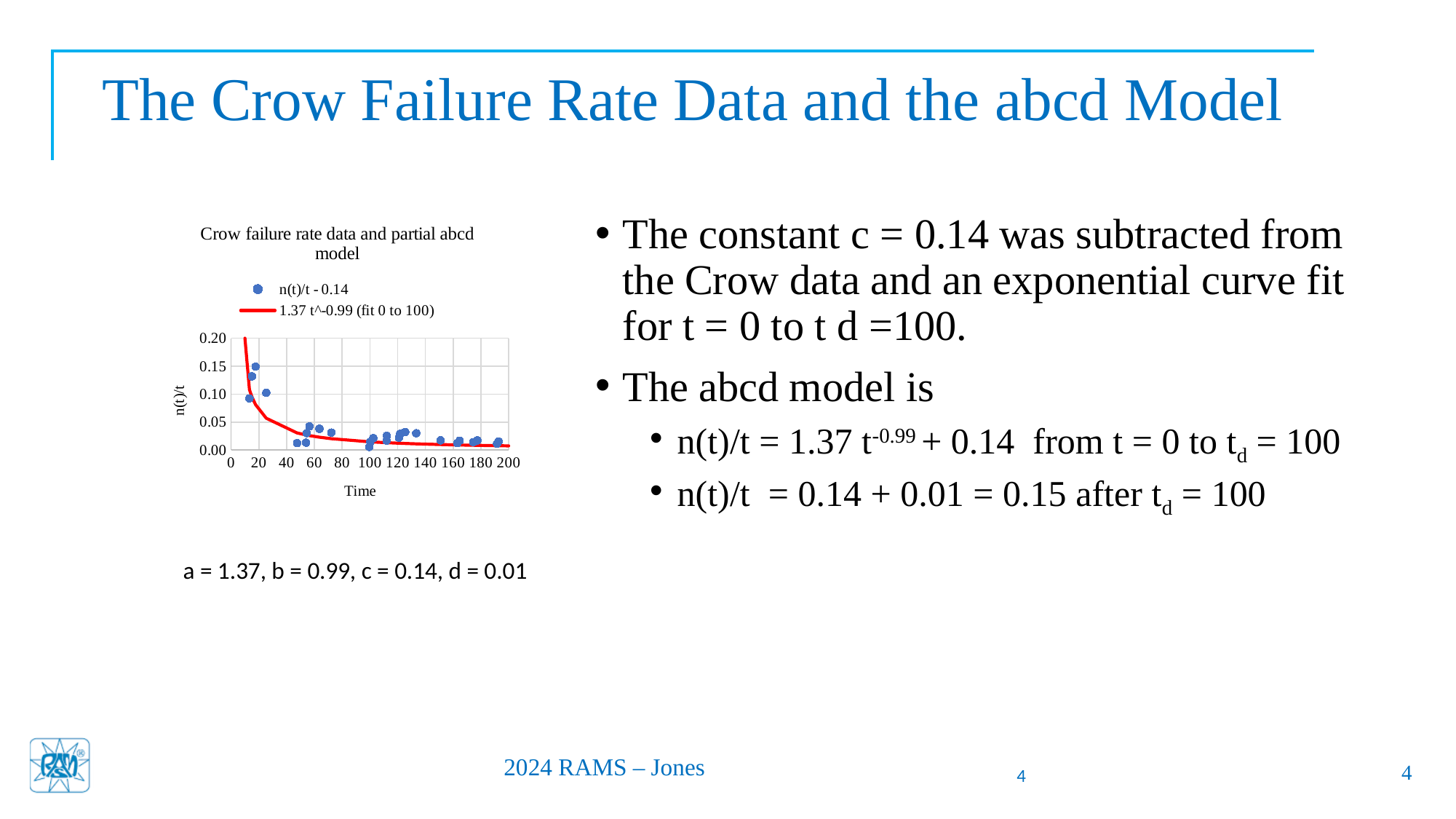
Is the value of the fitted red curve at Time = 100 greater or less than 0.05? less How many series does the chart legend list? 2 Which is larger: the data point near Time = 20 or the data point near Time = 180? the data point near Time = 20 Does the fitted red curve rise or fall along the Time axis? fall Do the plotted n(t)/t - 0.14 values rise or fall as Time increases? fall What is the title of the chart? Crow failure rate data and partial abcd model Are the data points plotted at times beyond 100 greater or less than 0.05? less What kind of chart is shown on the slide? scatter chart What are the two legend entries of the chart? n(t)/t - 0.14 and 1.37 t^-0.99 (fit 0 to 100) Is the highest plotted data point greater or less than 0.10? greater